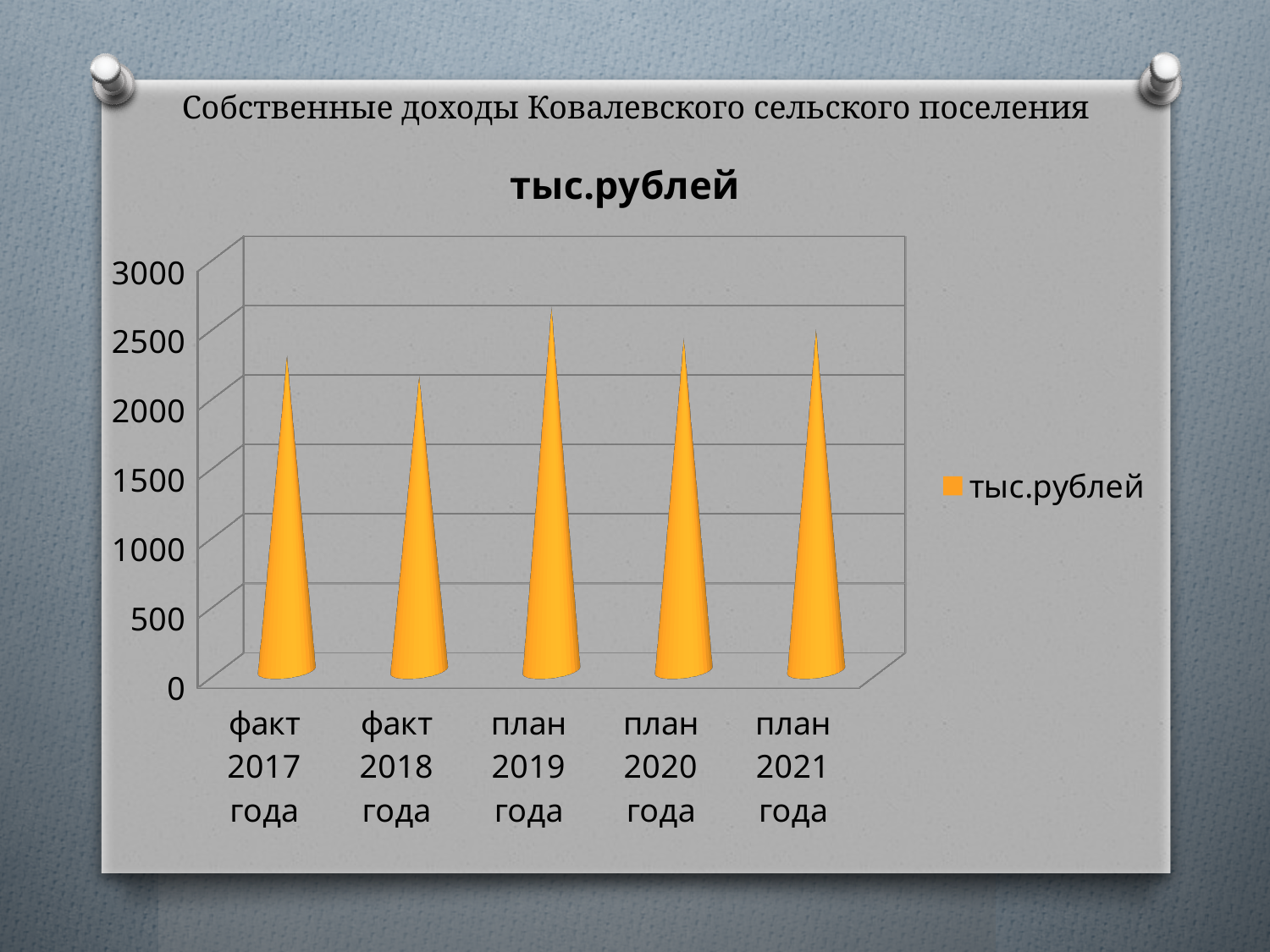
What is the title of the chart? тыс.рублей Which is larger, the value for план 2019 года or the value for факт 2018 года? план 2019 года What is the legend entry for the plotted series? тыс.рублей What kind of chart is shown on the slide? bar chart How many series does the legend list? 1 Is the value for план 2019 года greater or less than 2500? greater Is the value for план 2021 года greater or less than 3000? less Which category has the highest value? план 2019 года Is the value for факт 2017 года greater or less than 2000? greater How many categories are plotted on the x axis? 5 Which category has the lowest value? факт 2018 года